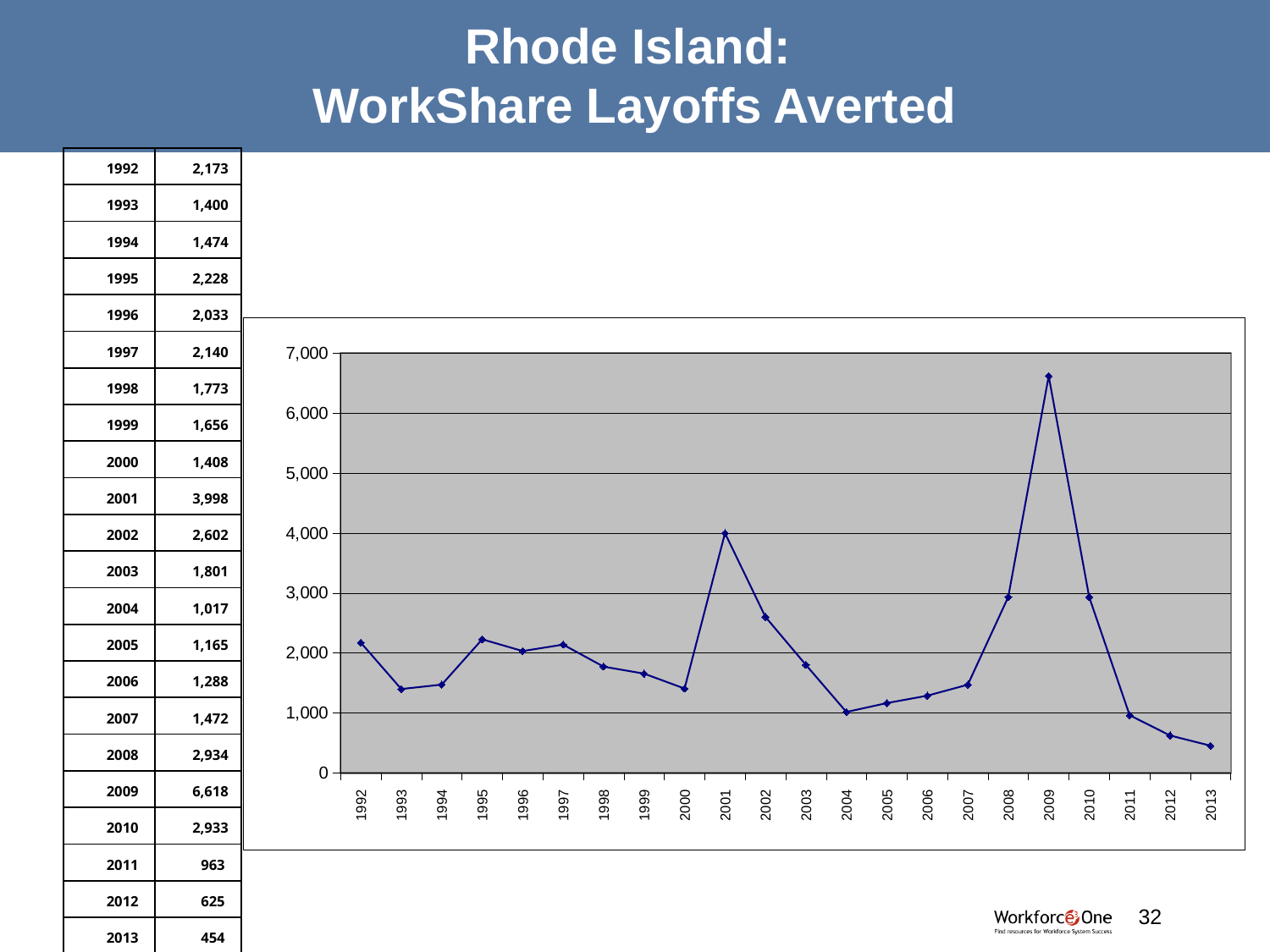
What is the value for 2009? 6,618 Which year has the lowest value on the chart? 2013 Do the values rise or fall from 2009 to 2013? fall Is the value for 2004 greater or less than 2,000? less What kind of chart is shown on the slide? line chart What is the title of the slide containing the chart? Rhode Island: WorkShare Layoffs Averted Which is larger, the value for 2001 or the value for 2002? 2001 What is the value for 2001? 3,998 What is the difference between the values for 2009 and 2010? 3,685 How many years are plotted on the chart? 22 Which year has the highest value on the chart? 2009 What is the value for 1992? 2,173